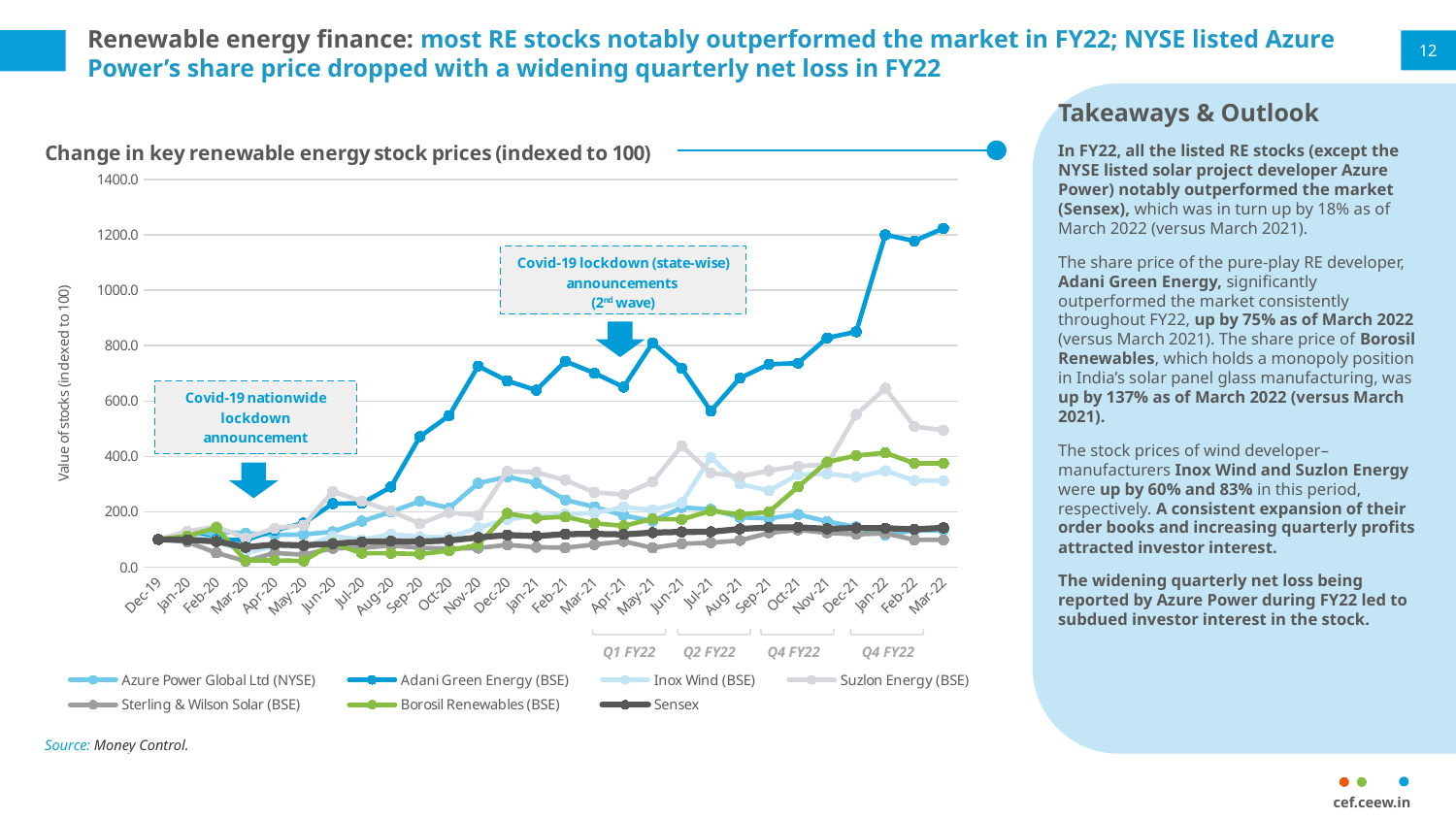
Is the value for Sensex at Mar-22 greater or less than 200? less Does the Adani Green Energy (BSE) line generally rise or fall from Dec-19 to Mar-22? Rise Is the value for Suzlon Energy (BSE) at Jan-22 greater or less than 400? greater How many series does the legend list? 7 Which series reaches the highest value on the chart? Adani Green Energy (BSE) What kind of chart is shown on the slide? Line chart What is the label on the y axis of the chart? Value of stocks (indexed to 100) Which series has the highest value at Mar-22? Adani Green Energy (BSE) Which is larger at Mar-22, Adani Green Energy (BSE) or Sensex? Adani Green Energy (BSE) What is the title of the chart? Change in key renewable energy stock prices (indexed to 100) How many monthly points are shown along the x axis? 28 Is the value for Adani Green Energy (BSE) at Mar-22 greater or less than 1000? greater